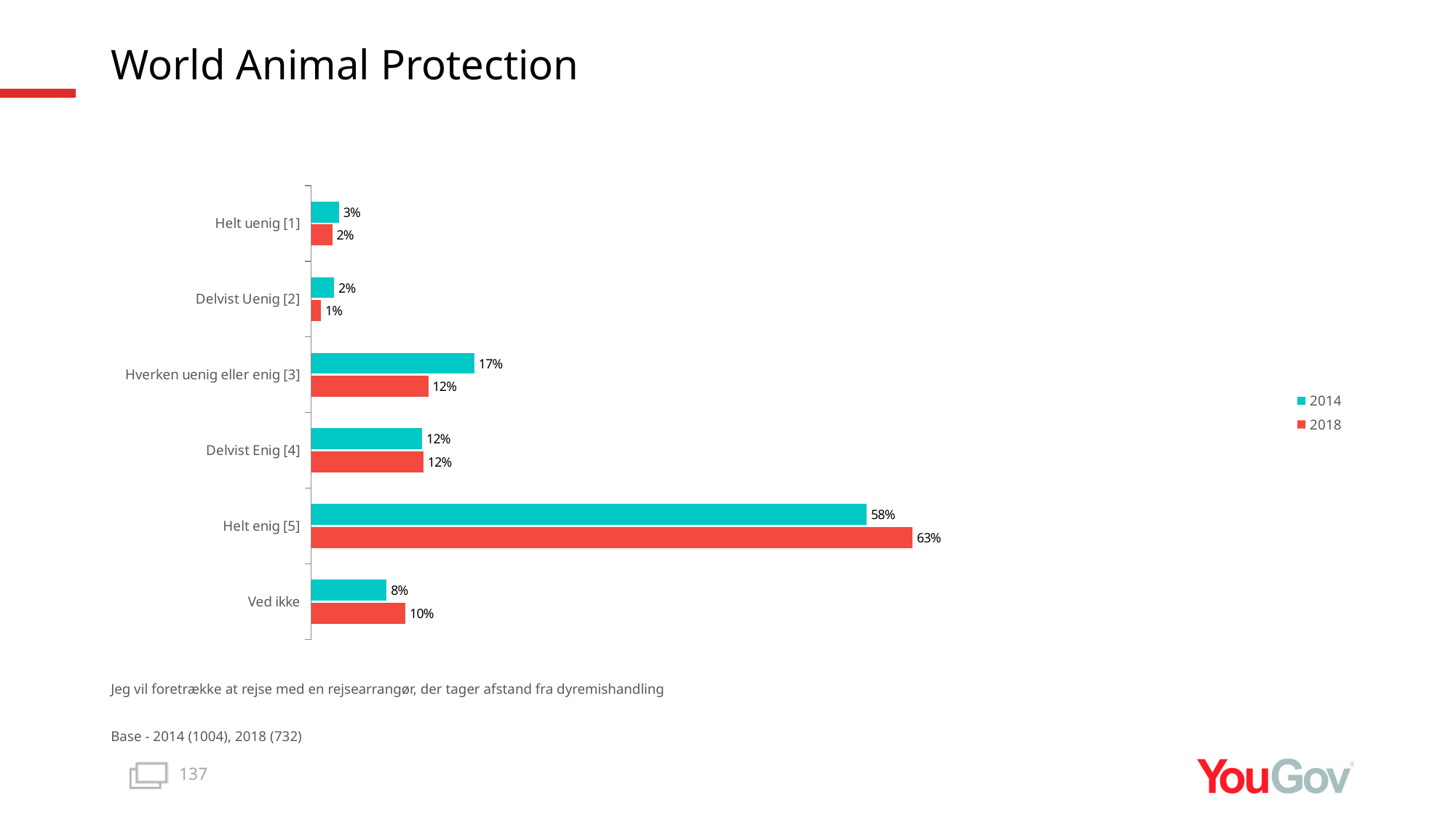
What is the difference between the 2018 and 2014 values for Helt enig [5]? 5% How many series does the legend list? 2 Which series is shown in red in the legend? 2018 Which category has the lowest 2018 value? Delvist Uenig [2] What kind of chart is shown on the slide? Bar chart What is the difference between the 2014 and 2018 values for Hverken uenig eller enig [3]? 5% What is the 2014 value for Hverken uenig eller enig [3]? 17% What is the 2018 value for Ved ikke? 10% What is the 2018 value for Helt enig [5]? 63% Which category has the highest 2014 value? Helt enig [5] How many categories are shown on the chart? 6 Which is larger for Ved ikke: the 2014 value or the 2018 value? 2018